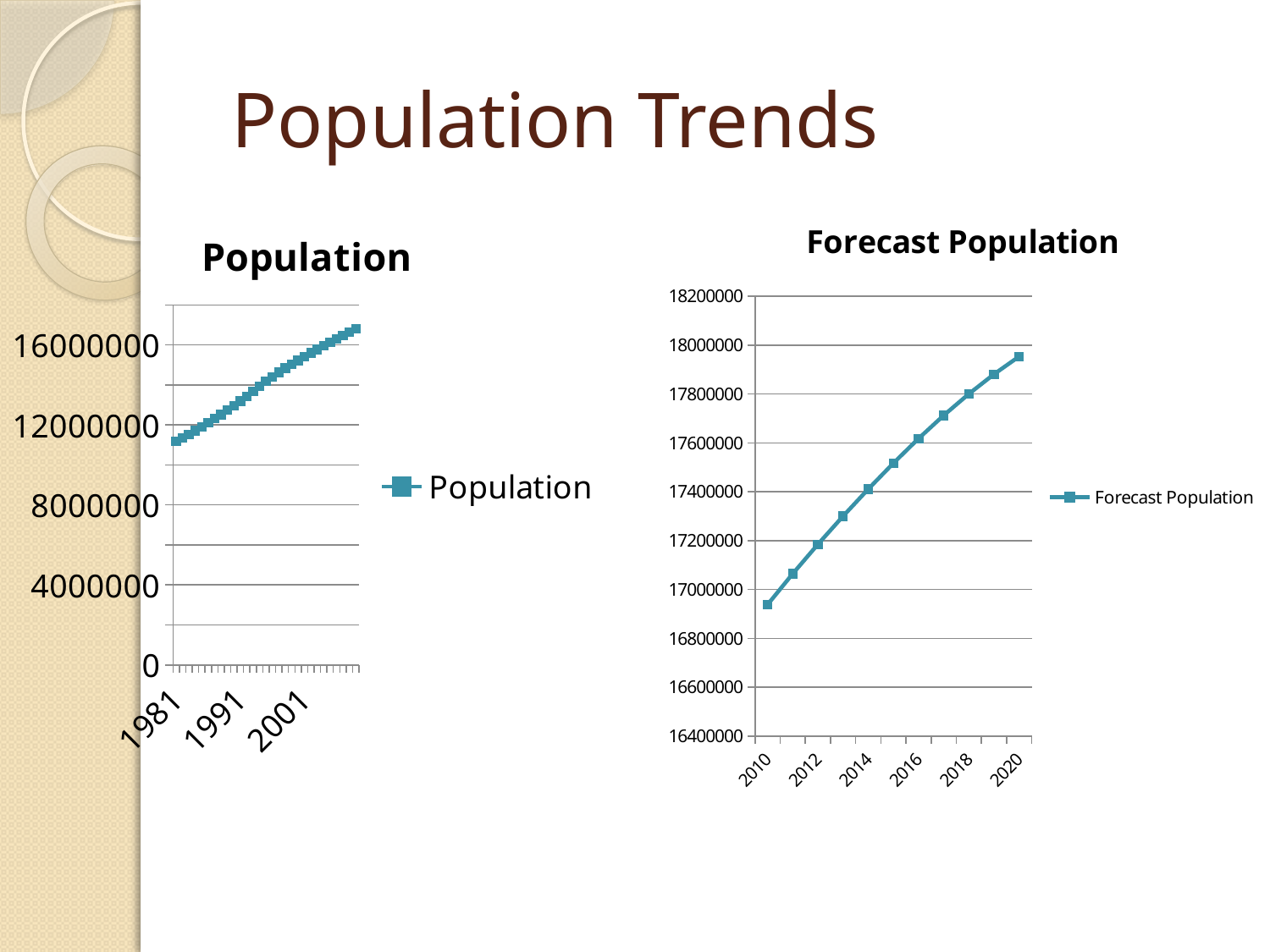
How many series does the legend of the Forecast Population chart list? 1 What is the legend entry of the chart on the left? Population What kind of chart is the Population chart on the left? line chart In the Forecast Population chart, is the value for 2010 greater or less than 17000000? less In the Forecast Population chart, do the values rise or fall from 2010 to 2020? rise In the Forecast Population chart, which year has the lowest value? 2010 In the Population chart on the left, do the values rise or fall along the x axis? rise In the Forecast Population chart, which year has the highest value? 2020 In the Forecast Population chart, is the value for 2020 greater or less than 18000000? less In the Population chart on the left, is the value for 1981 greater or less than 12000000? less How many data points are plotted in the Forecast Population chart? 11 What kind of chart is the Forecast Population chart? line chart